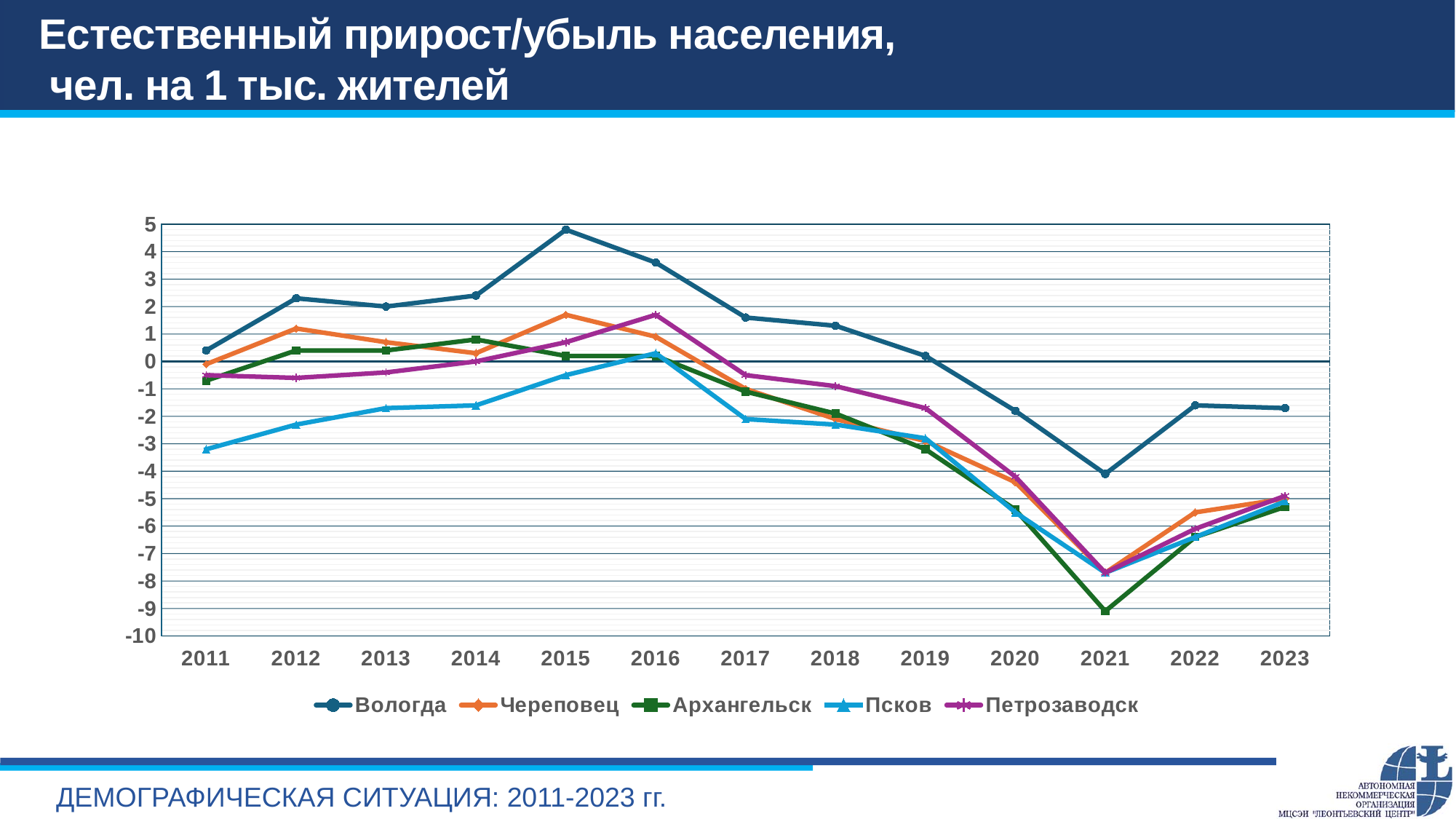
In 2020, which is larger: the value for Вологда or the value for Архангельск? Вологда Which city has the lowest value in 2021? Архангельск What is the title of the chart on the slide? Естественный прирост/убыль населения, чел. на 1 тыс. жителей How many series does the legend list? 5 Which city has the highest value in 2015? Вологда Does the value for Вологда rise or fall from 2015 to 2021? fall Is the value for Псков in 2011 greater or less than -2? less Is the value for Архангельск in 2021 greater or less than -8? less Which city has the highest value in 2023? Вологда Is the value for Вологда in 2015 greater or less than 4? greater How many years are shown along the x axis? 13 What kind of chart is shown on the slide? line chart